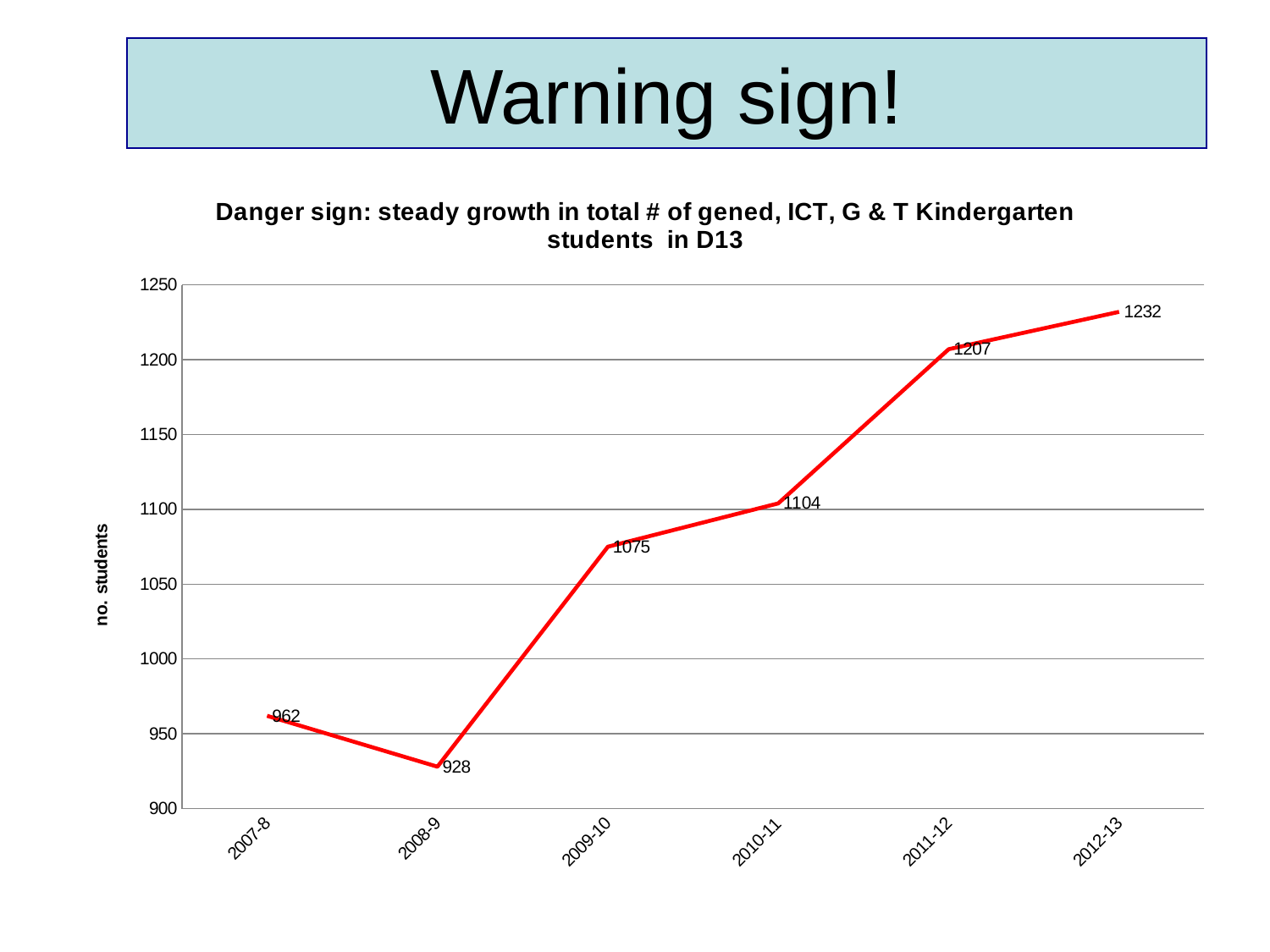
What is the number of students for 2011-12? 1207 Which year has the lowest number of students? 2008-9 What kind of chart is shown on the slide? Line chart Which year has more students, 2008-9 or 2010-11? 2010-11 How many years are plotted on the chart? 6 What is the number of students for 2007-8? 962 Which year has the highest number of students? 2012-13 What is the difference in number of students between 2010-11 and 2009-10? 29 What is the label of the vertical axis? no. students What is the number of students for 2009-10? 1075 What is the difference in number of students between 2012-13 and 2007-8? 270 What is the number of students for 2008-9? 928